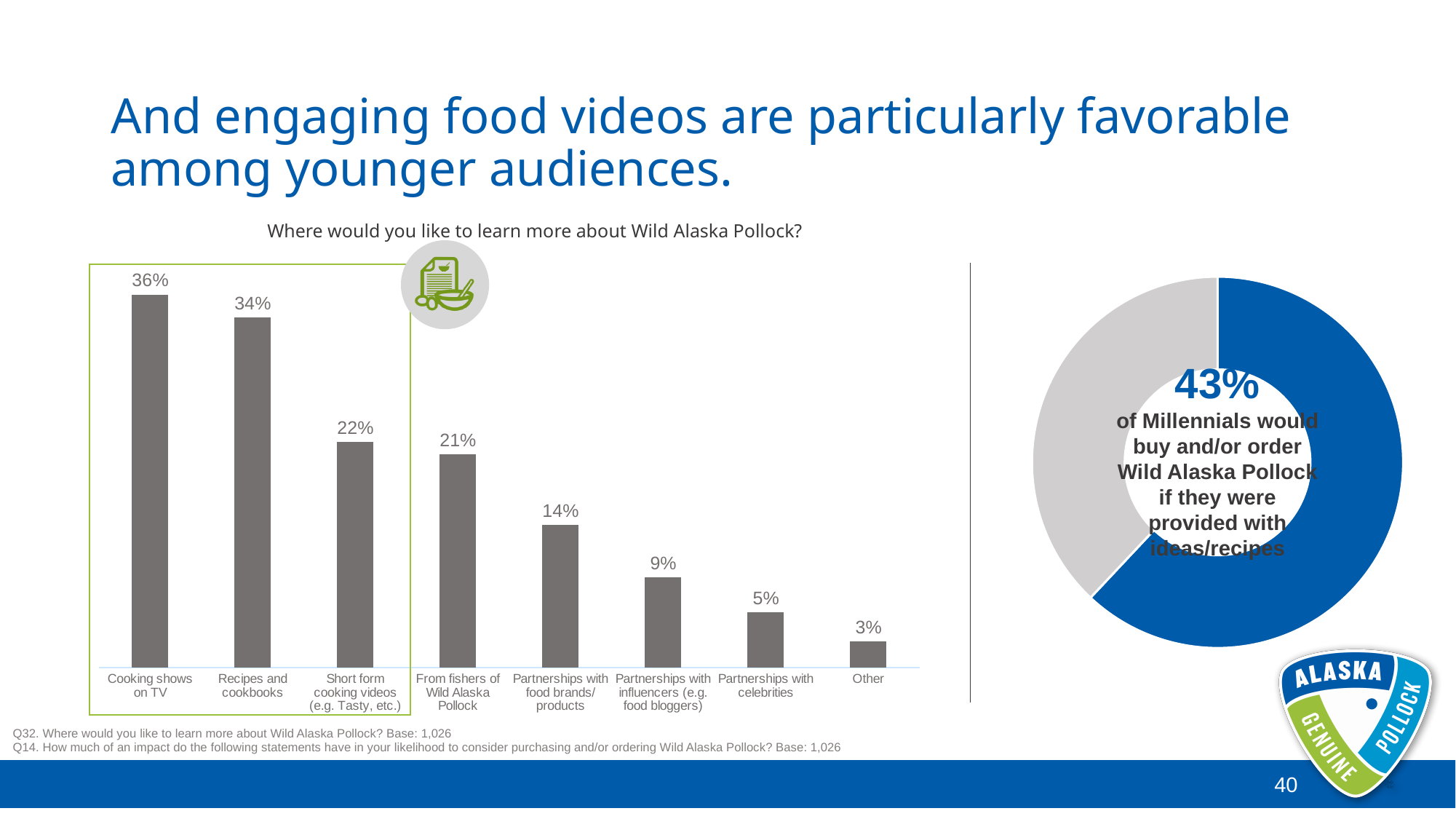
What kind of chart is the chart on the right of the slide? Donut chart In the bar chart 'Where would you like to learn more about Wild Alaska Pollock?', do the values rise or fall from left to right? Fall In the bar chart 'Where would you like to learn more about Wild Alaska Pollock?', which category has the lowest value? Other In the bar chart 'Where would you like to learn more about Wild Alaska Pollock?', what is the value for Cooking shows on TV? 36% How many categories are shown in the bar chart 'Where would you like to learn more about Wild Alaska Pollock?'? 8 In the bar chart 'Where would you like to learn more about Wild Alaska Pollock?', which category has the highest value? Cooking shows on TV In the bar chart 'Where would you like to learn more about Wild Alaska Pollock?', what is the value for Short form cooking videos (e.g. Tasty, etc.)? 22% What kind of chart is the chart on the left of the slide? Bar chart In the bar chart 'Where would you like to learn more about Wild Alaska Pollock?', which is larger: Partnerships with food brands/products or Partnerships with celebrities? Partnerships with food brands/products In the donut chart on the right of the slide, what share of Millennials would buy and/or order Wild Alaska Pollock if they were provided with ideas/recipes? 43% In the bar chart 'Where would you like to learn more about Wild Alaska Pollock?', what is the value for Partnerships with influencers (e.g. food bloggers)? 9% In the bar chart 'Where would you like to learn more about Wild Alaska Pollock?', what is the difference between Recipes and cookbooks and From fishers of Wild Alaska Pollock? 13%